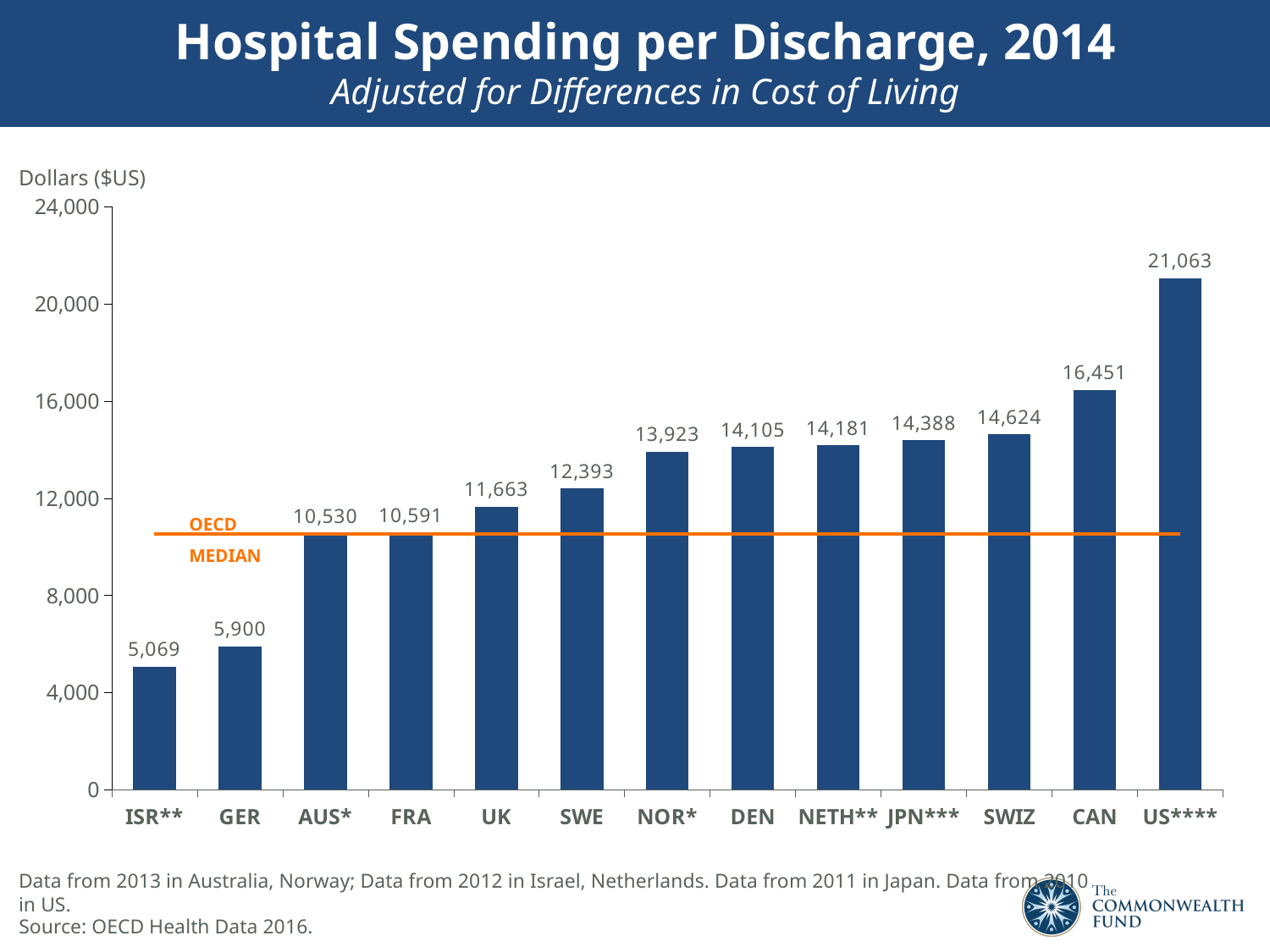
What does the orange horizontal line on the chart represent? OECD MEDIAN What type of chart is shown on the slide? bar chart What is the value shown for NETH**? 14,181 How many countries are shown on the chart? 13 Which is larger, the value for SWE or the value for NOR*? NOR* Which country has the highest hospital spending per discharge? US**** What is the hospital spending per discharge for CAN? 16,451 What is the difference between the values for US**** and CAN? 4,612 Is the value for SWIZ greater or less than 16,000? less What is the difference between the values for GER and ISR**? 831 Which country has the lowest hospital spending per discharge? ISR** What is the hospital spending per discharge for the UK? 11,663